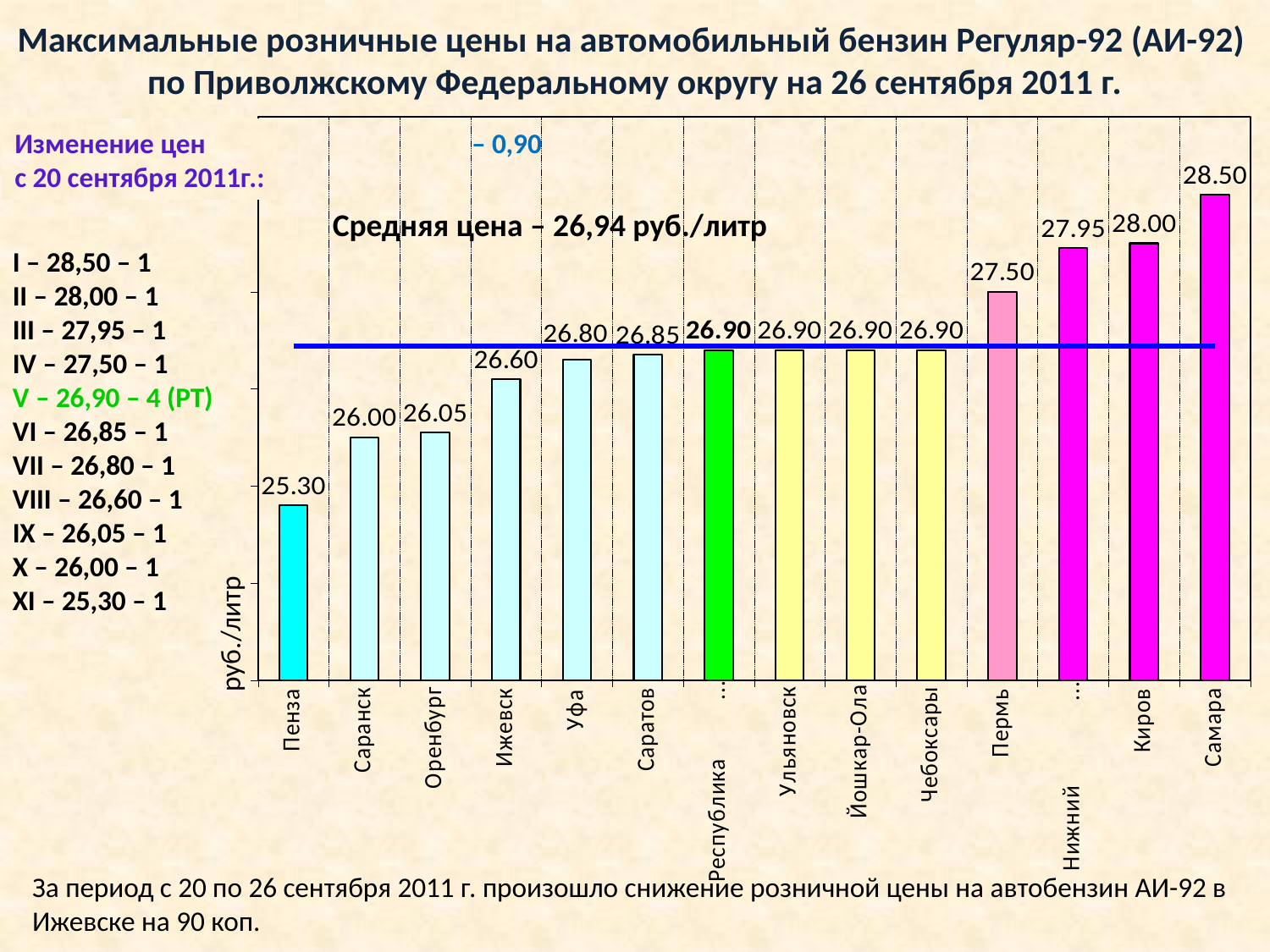
What is the difference between the prices for Самара and Пенза? 3.20 Which city has the highest price on the chart? Самара What average price is stated on the chart (the horizontal line)? 26,94 руб./литр Which has a higher price, Уфа or Оренбург? Уфа Which city has the lowest price on the chart? Пенза What is the price shown for Пенза? 25.30 What is the price shown for Ижевск? 26.60 What is the price shown for Пермь? 27.50 How many cities (bars) are shown on the chart? 14 What is the price shown for Самара? 28.50 What is the difference between the prices for Киров and Саратов? 1.15 What type of chart is shown on the slide? Bar chart